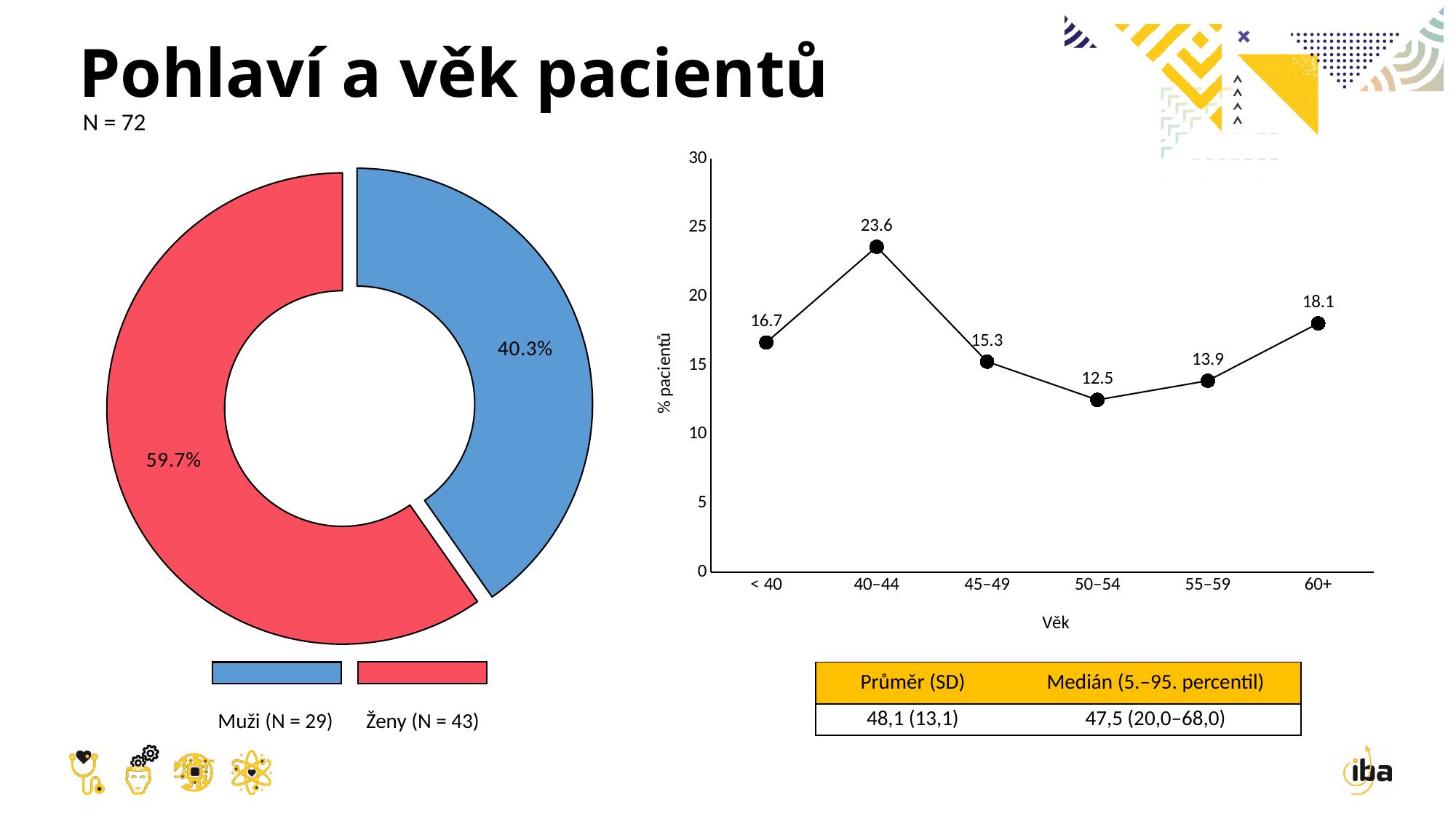
In the donut chart on the left, what percentage is shown for Ženy? 59.7% In the line chart on the right, how many age groups are plotted on the x axis? 6 In the line chart on the right, which age group has the highest percentage of patients? 40–44 In the line chart on the right, what is the value for the 40–44 age group? 23.6 In the donut chart on the left, what is the difference in percentage points between Ženy and Muži? 19.4 In the line chart on the right, which age group has the lowest percentage of patients? 50–54 In the donut chart on the left, what percentage is shown for Muži? 40.3% What type of chart is shown on the right side of the slide? Line chart In the line chart on the right, what is the difference between the values for 40–44 and 50–54? 11.1 In the donut chart on the left, how many categories does the legend list? 2 In the line chart on the right, what is the value for the 60+ age group? 18.1 In the donut chart on the left, which group has the larger share, Muži or Ženy? Ženy